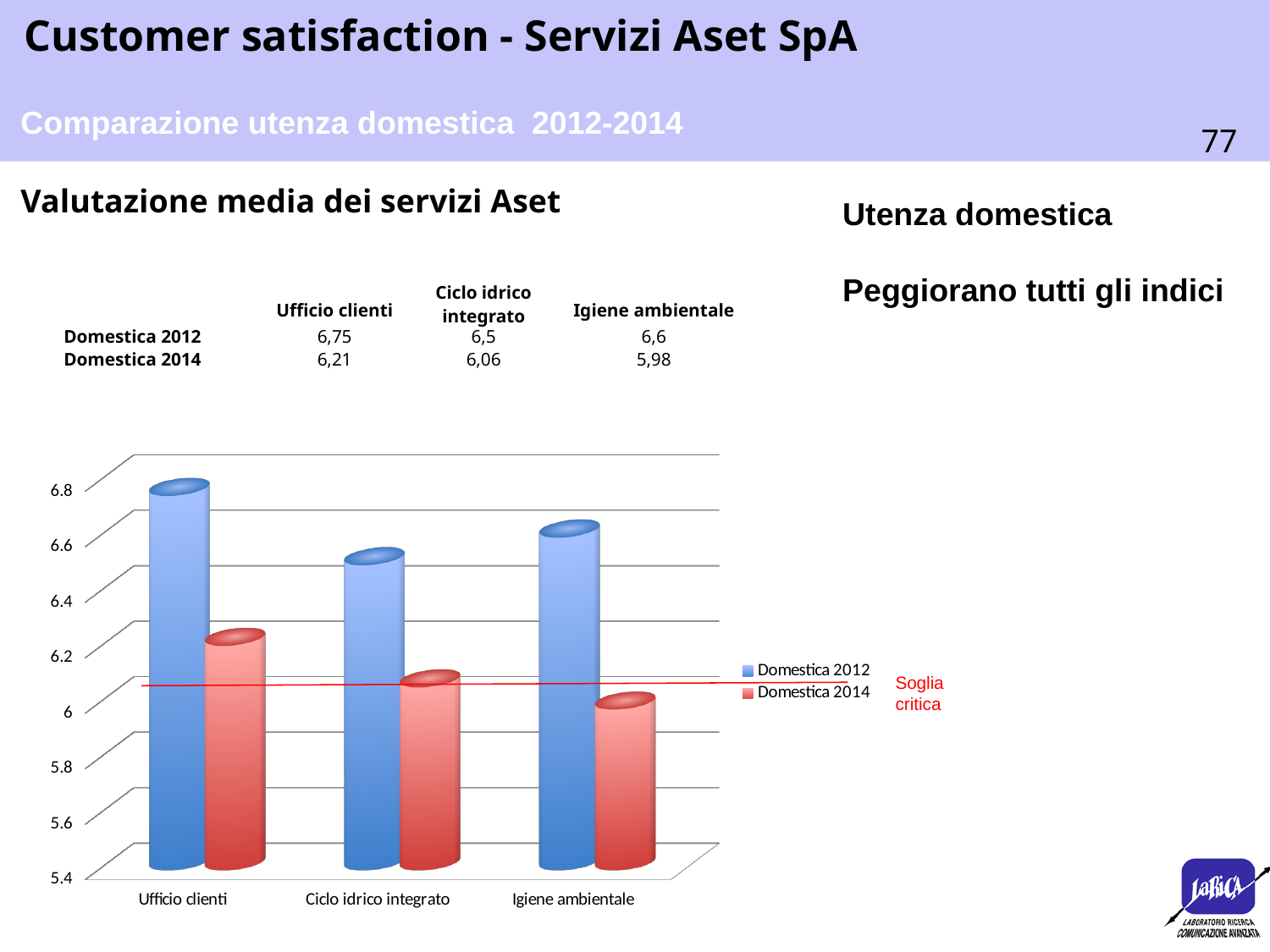
What type of chart is shown on the slide? bar chart What is the value for Igiene ambientale in the Domestica 2014 series? 5,98 What is the value for Ufficio clienti in the Domestica 2012 series? 6,75 Which category has the lowest value in the Domestica 2014 series? Igiene ambientale Which category has the highest value in the Domestica 2012 series? Ufficio clienti Is the Domestica 2014 value for Igiene ambientale greater or less than 6? less What is the value for Ciclo idrico integrato in the Domestica 2014 series? 6,06 Which is larger for Ciclo idrico integrato: the Domestica 2012 value or the Domestica 2014 value? Domestica 2012 How many categories are shown on the x axis of the chart? 3 How many series does the chart legend list? 2 What does the red horizontal line on the chart represent, according to its label? Soglia critica What is the difference between the Domestica 2012 and Domestica 2014 values for Igiene ambientale? 0,62